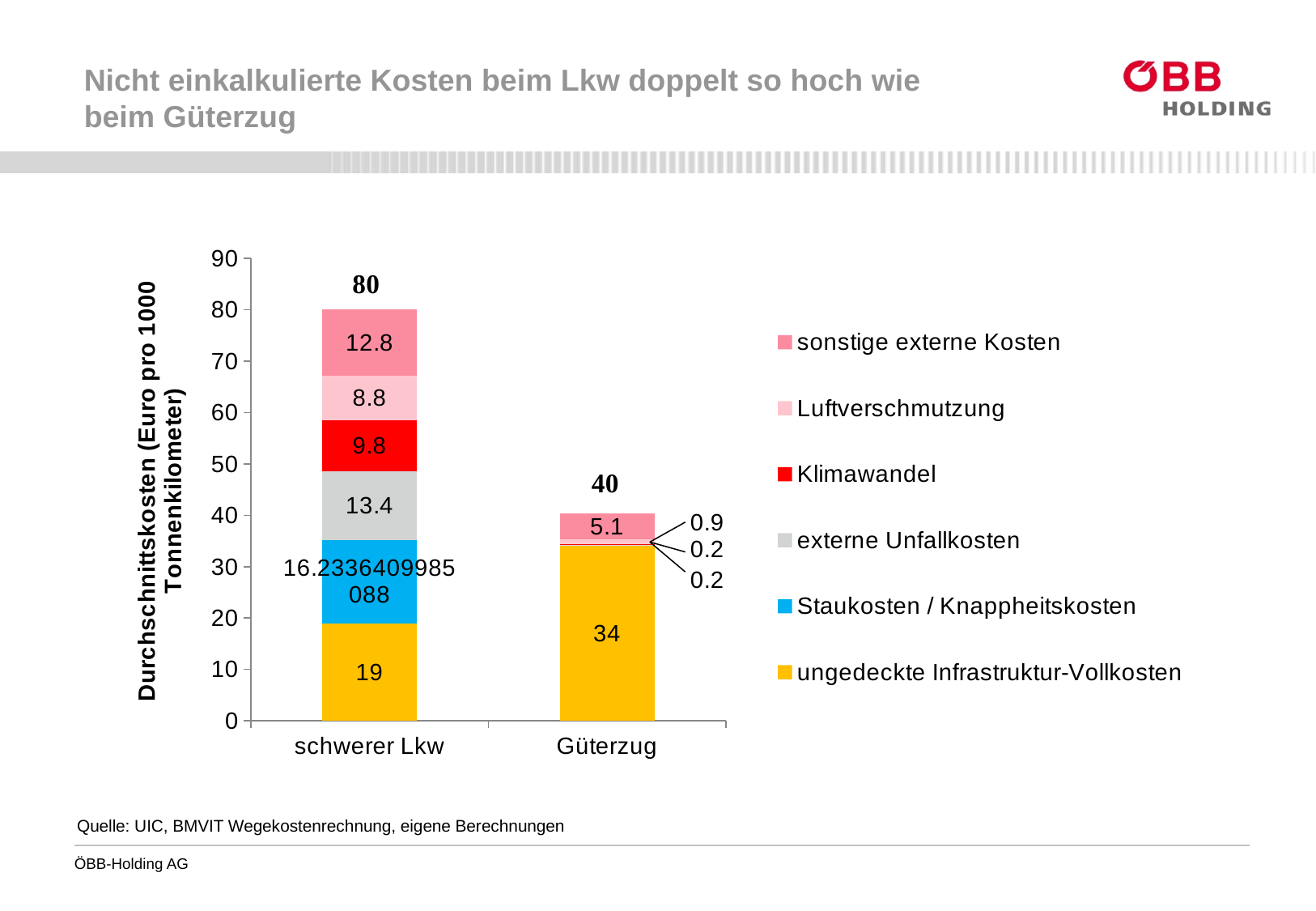
Which category has the higher total, schwerer Lkw or Güterzug? schwerer Lkw What is the value of sonstige externe Kosten for Güterzug? 5.1 How many categories are shown on the x axis of the chart? 2 What kind of chart is shown on the slide? Stacked bar chart What is the title of the vertical axis? Durchschnittskosten (Euro pro 1000 Tonnenkilometer) What is the total value of the stacked bar for schwerer Lkw? 80 How many series does the legend list? 6 What is the total value of the stacked bar for Güterzug? 40 What is the value of ungedeckte Infrastruktur-Vollkosten for Güterzug? 34 What is the value of Klimawandel for schwerer Lkw? 9.8 What is the difference between the total for schwerer Lkw and the total for Güterzug? 40 What is the value of externe Unfallkosten for schwerer Lkw? 13.4